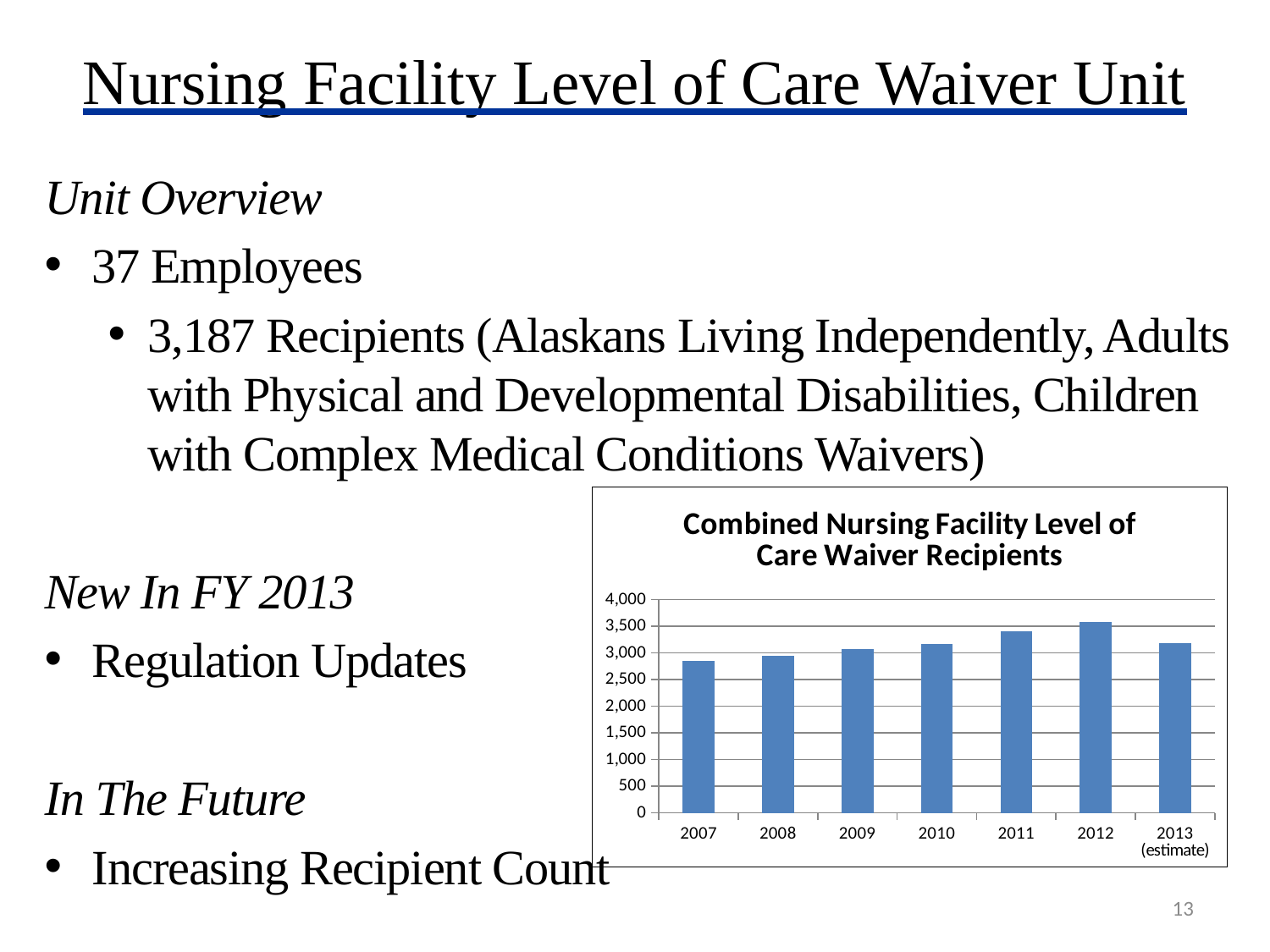
Is the value for 2011 greater or less than 3,500? less Is the value for 2007 greater or less than 3,000? less What is the title of the chart? Combined Nursing Facility Level of Care Waiver Recipients Is the value for 2012 greater or less than 3,500? greater What type of chart is shown on the slide? Bar chart Which year has the lowest number of recipients in the chart? 2007 Which year has the highest number of recipients in the chart? 2012 Which is larger, the value for 2011 or the value for 2013 (estimate)? 2011 How many years (categories) are plotted on the x axis of the chart? 7 Which is larger, the value for 2007 or the value for 2012? 2012 Do the values rise or fall from 2007 to 2012? rise